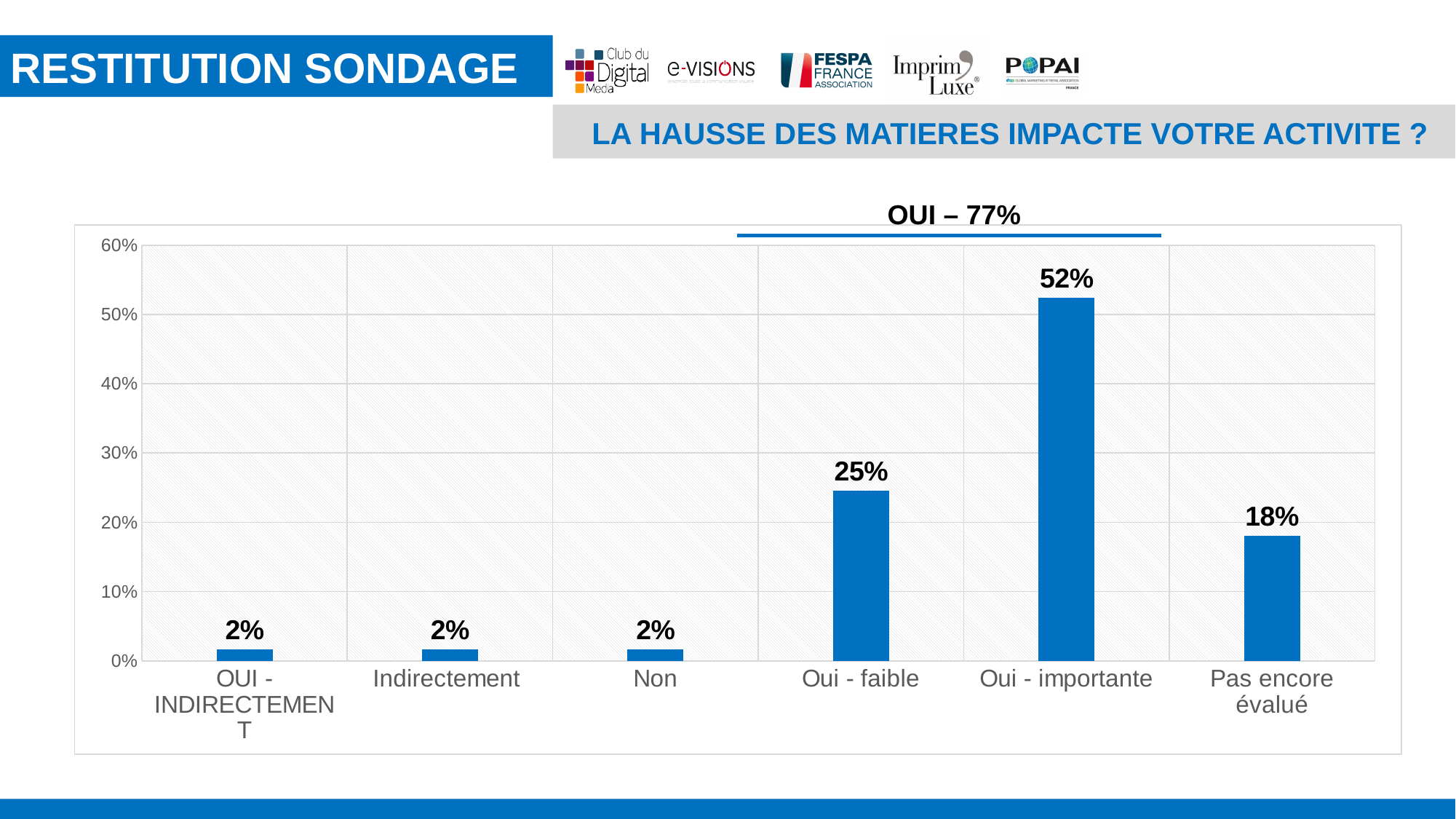
Is the value for "Oui - importante" greater or less than 50%? greater What is the value for "Oui - importante"? 52% Which category has the highest value? Oui - importante How many categories are shown on the x axis? 6 What is the difference between "Oui - importante" and "Oui - faible"? 27% What kind of chart is shown on the slide? Bar chart Which is larger, "Oui - faible" or "Pas encore évalué"? Oui - faible What is the value for "Non"? 2% What is the difference between "Oui - faible" and "Pas encore évalué"? 7% What is the value for "Pas encore évalué"? 18% What combined percentage is shown above the bracket over the "Oui" categories? 77% What is the value for "Oui - faible"? 25%